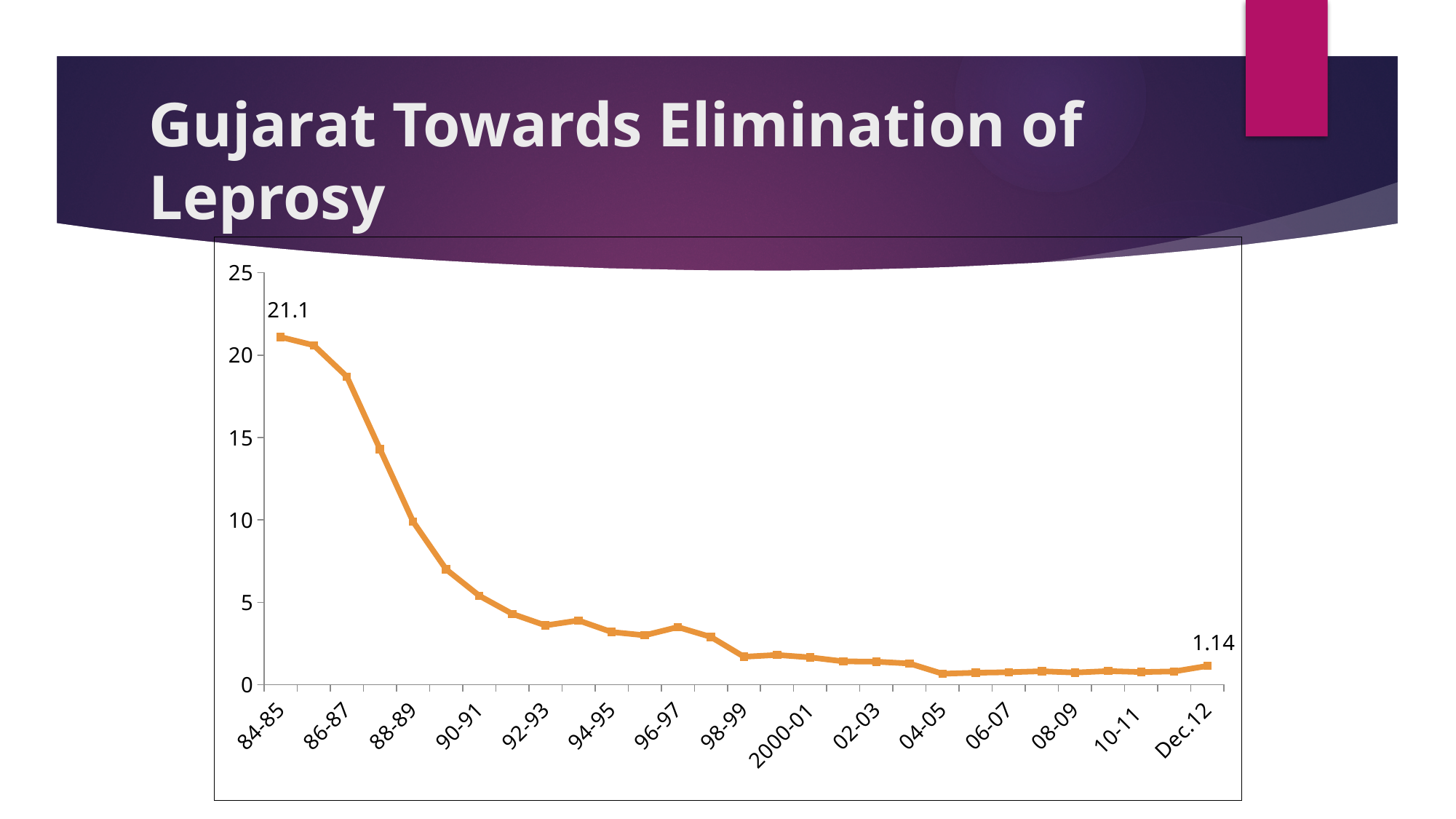
What is the difference between the value for 84-85 and the value for Dec.12? 19.96 Do the values rise or fall from 84-85 to Dec.12? Fall What colour is the plotted line? Orange What is the value for Dec.12? 1.14 What is the value for 84-85? 21.1 Is the value for 90-91 greater or less than 10? less Is the value for 96-97 greater or less than 5? less What kind of chart is shown on the slide? Line chart What is the title of the slide containing the chart? Gujarat Towards Elimination of Leprosy Is the value for 86-87 greater or less than 15? greater Which is larger, the value for 84-85 or the value for Dec.12? 84-85 Which period has the highest value? 84-85